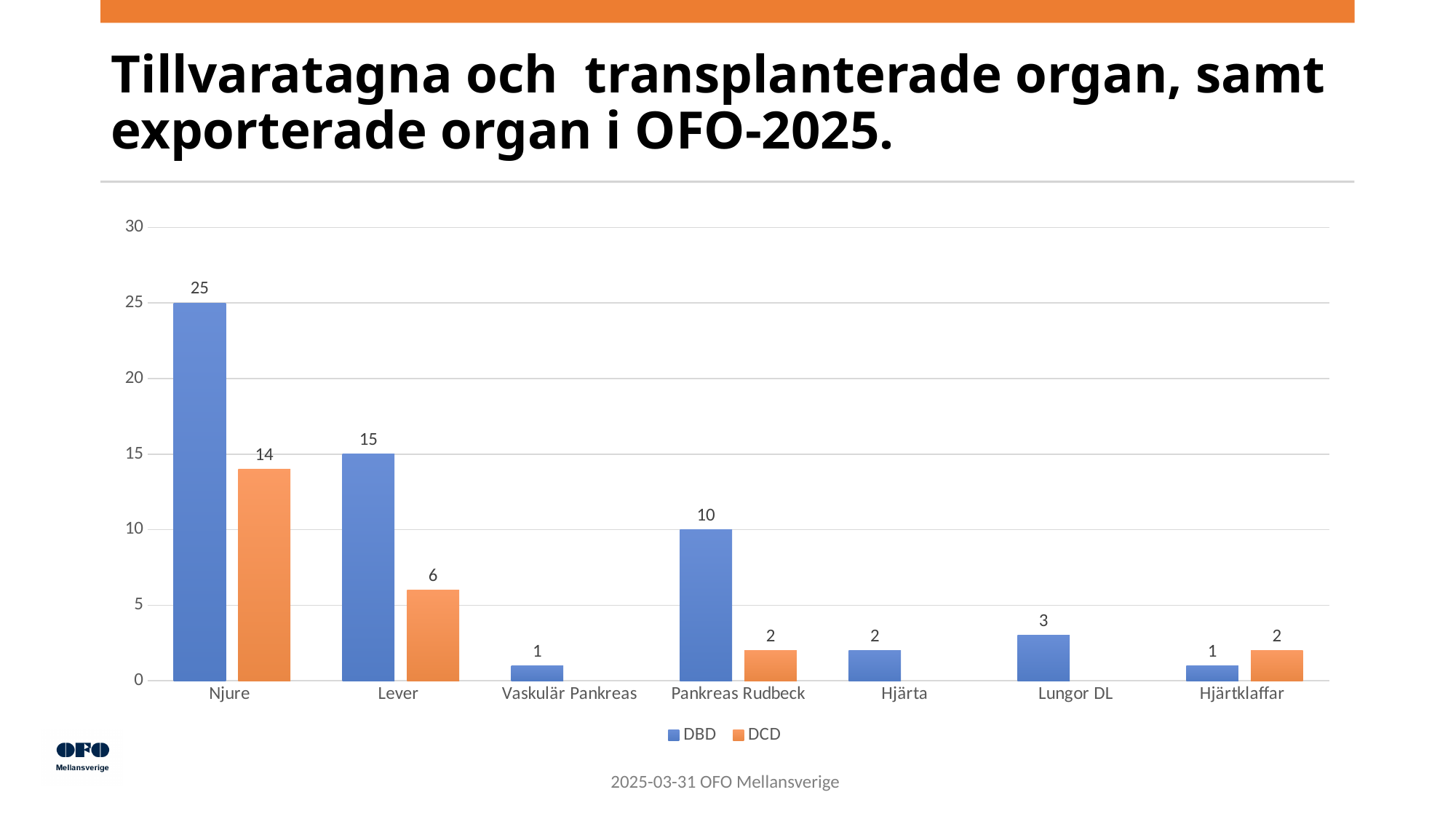
What is the difference between the DBD and DCD values for Njure? 11 What is the DCD value for Hjärtklaffar? 2 What is the DBD value for Njure? 25 What is the DCD value for Lever? 6 What kind of chart is shown on the slide? Bar chart What colour are the DCD bars? Orange Which is larger for Lever, the DBD value or the DCD value? DBD Which category has the lowest DBD value? Vaskulär Pankreas and Hjärtklaffar (both 1) Which category has the highest DBD value? Njure How many series does the legend list? 2 How many categories are shown on the x axis? 7 What is the DBD value for Pankreas Rudbeck? 10